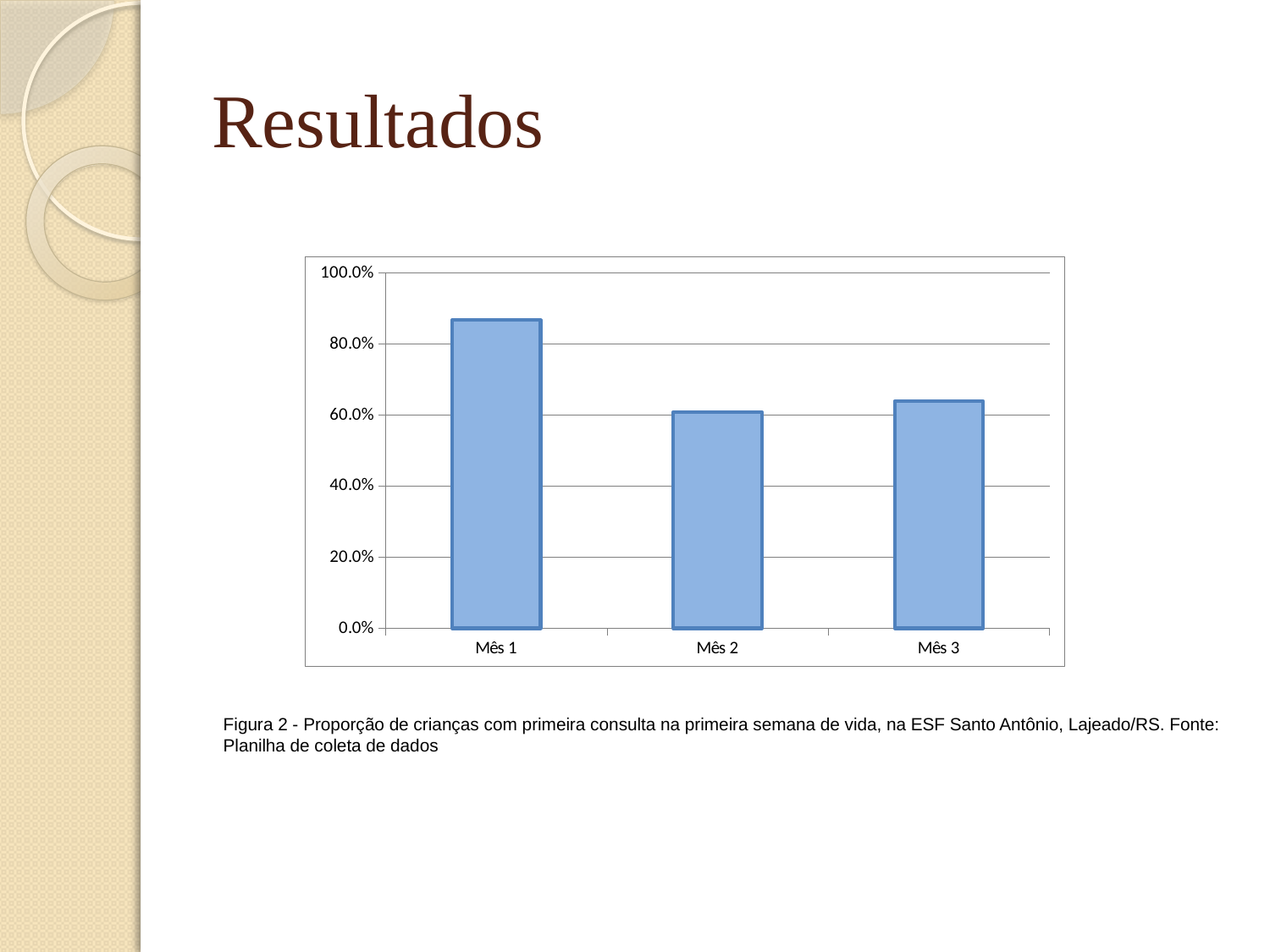
Which is larger, the value for Mês 1 or the value for Mês 3? Mês 1 Is the value for Mês 1 greater or less than 100.0%? less How many categories (months) are plotted on the chart? 3 Which month has the highest proportion on the chart? Mês 1 What is the highest value shown on the vertical axis of the chart? 100.0% Is the value for Mês 3 greater or less than 80.0%? less Is the value for Mês 2 greater or less than 40.0%? greater Which is larger, the value for Mês 1 or the value for Mês 2? Mês 1 What kind of chart is shown on the slide? bar chart What is the label of the first category on the horizontal axis? Mês 1